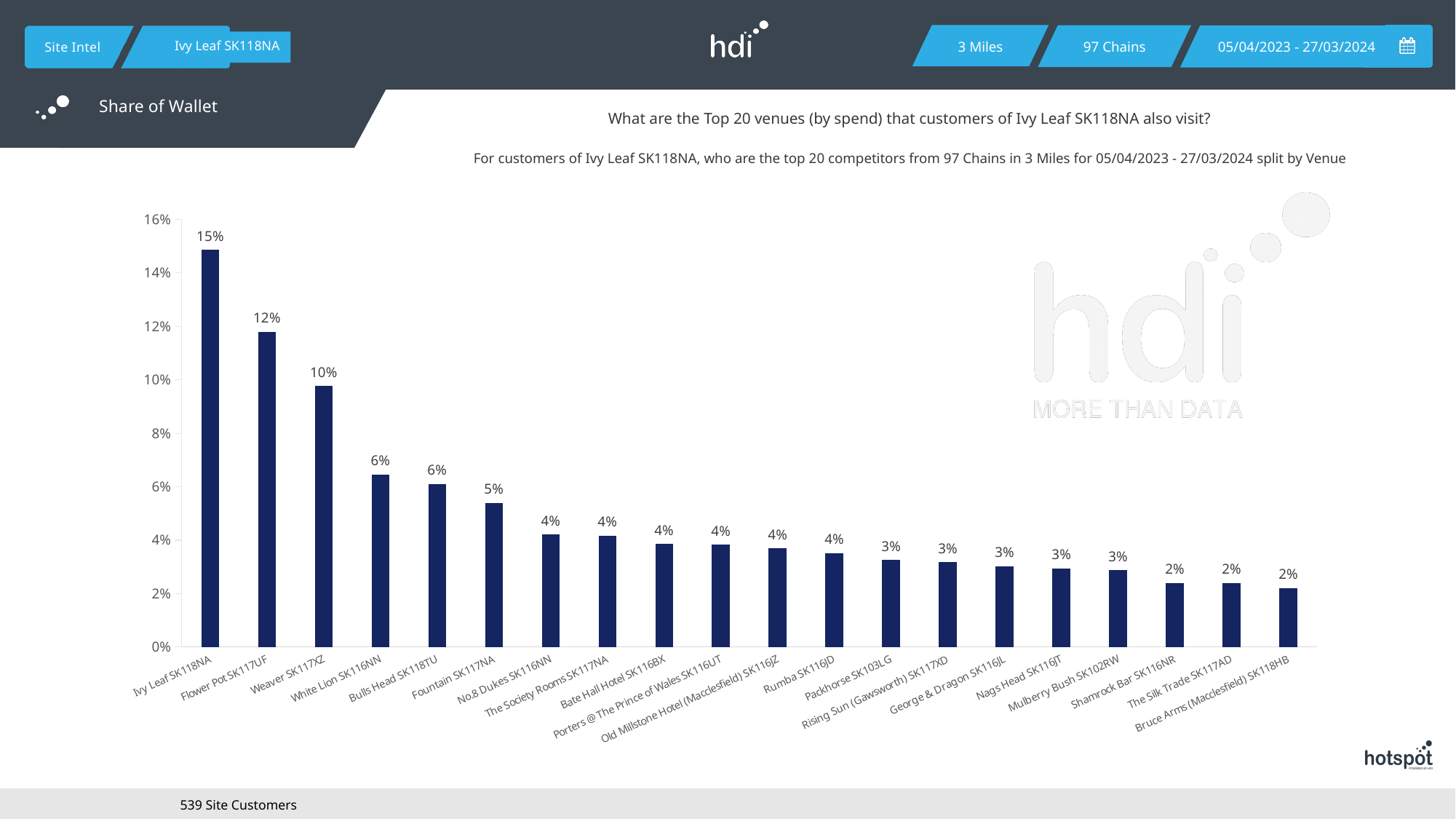
What is the value for Packhorse SK103LG? 3% What is the difference between the values for Ivy Leaf SK118NA and Flower Pot SK117UF? 3% What is the value for Fountain SK117NA? 5% What is the value for Flower Pot SK117UF? 12% What kind of chart is shown on the slide? bar chart What is the value for Ivy Leaf SK118NA? 15% Which venue has the highest value? Ivy Leaf SK118NA How many venues are shown on the chart? 20 Do the values rise or fall from left to right along the x axis? fall Which is larger, the value for Weaver SK117XZ or the value for White Lion SK116NN? Weaver SK117XZ Is the value for Flower Pot SK117UF greater or less than 10%? greater What is the value for Weaver SK117XZ? 10%